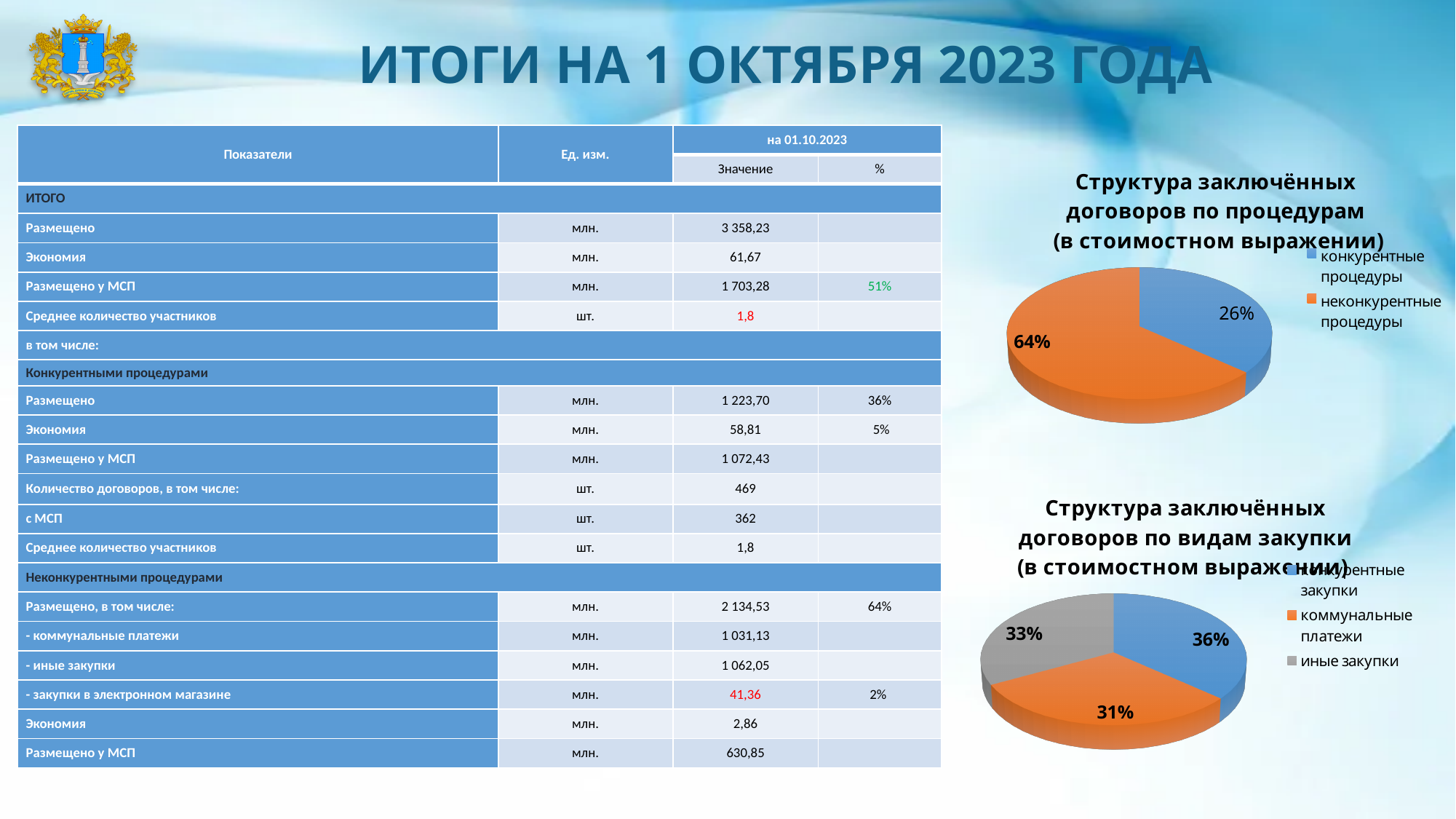
In the bottom pie chart 'Структура заключённых договоров по видам закупки', which category has the smallest slice? коммунальные платежи What type of chart is the top chart 'Структура заключённых договоров по процедурам'? pie chart In the top pie chart 'Структура заключённых договоров по процедурам', which category has the largest slice? неконкурентные процедуры In the top pie chart 'Структура заключённых договоров по процедурам', what share is shown for неконкурентные процедуры? 64% In the bottom pie chart 'Структура заключённых договоров по видам закупки', what is the difference in percentage points between иные закупки and коммунальные платежи? 2 percentage points In the bottom pie chart 'Структура заключённых договоров по видам закупки', how many categories does the legend list? 3 In the top pie chart 'Структура заключённых договоров по процедурам', what colour is the slice for неконкурентные процедуры? orange In the bottom pie chart 'Структура заключённых договоров по видам закупки', what share is shown for иные закупки? 33% In the top pie chart 'Структура заключённых договоров по процедурам', what share is shown for конкурентные процедуры? 26% In the bottom pie chart 'Структура заключённых договоров по видам закупки', what share is shown for the blue slice? 36% In the top pie chart 'Структура заключённых договоров по процедурам', how many slices does the pie have? 2 In the bottom pie chart 'Структура заключённых договоров по видам закупки', what share is shown for коммунальные платежи? 31%